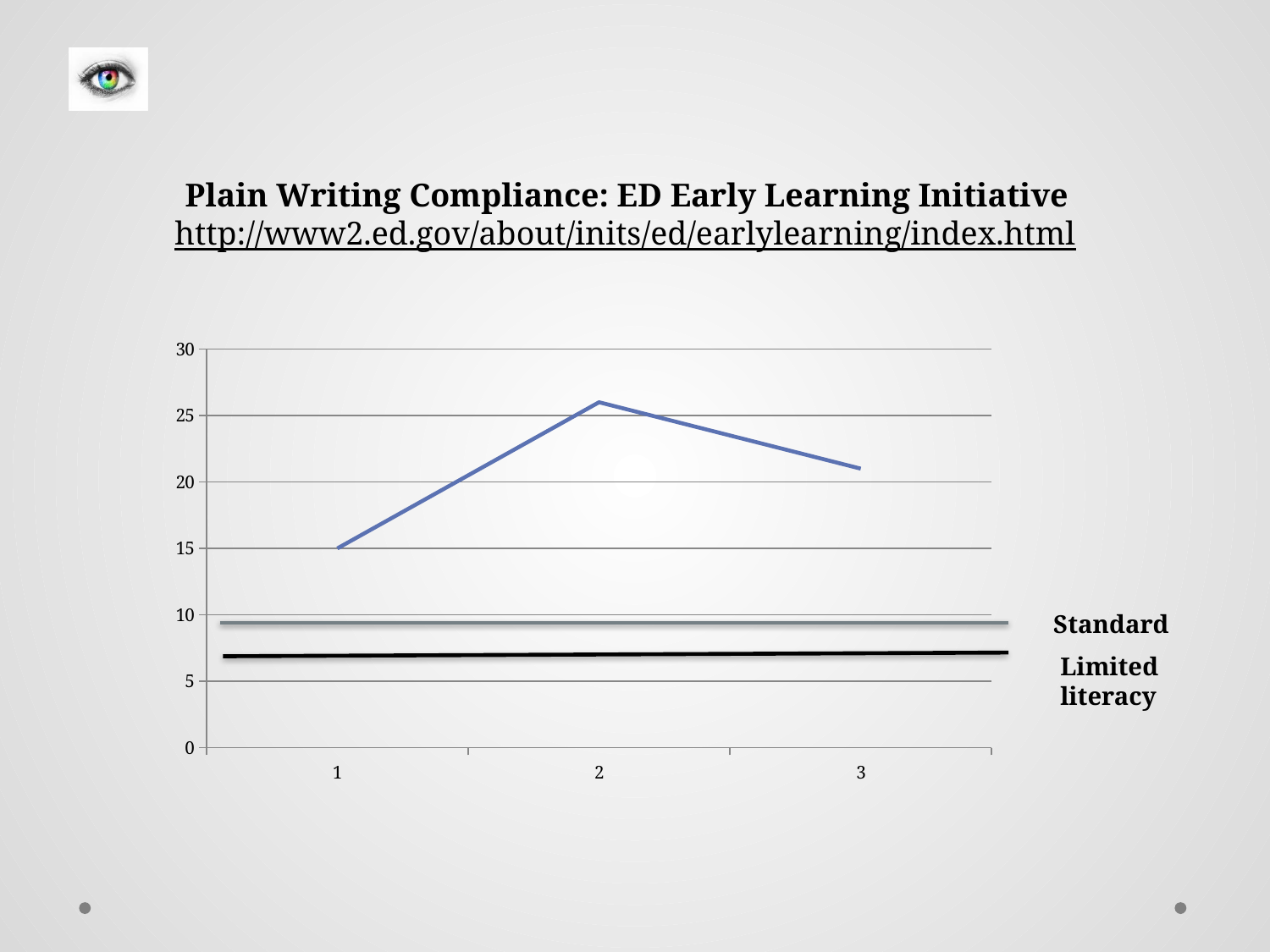
Does the blue line rise or fall from point 2 to point 3? fall Is the value of the blue line at point 1 greater or less than 20? less Is the Standard reference line greater or less than 10? less Which horizontal reference line is higher, Standard or Limited literacy? Standard At which x-axis point does the blue line reach its highest value? 2 Is the value of the blue line at point 3 greater or less than 25? less At which x-axis point does the blue line have its lowest value? 1 Does the blue line rise or fall from point 1 to point 2? rise How many points are plotted along the x axis of the blue line? 3 What kind of chart is shown on the slide? line chart